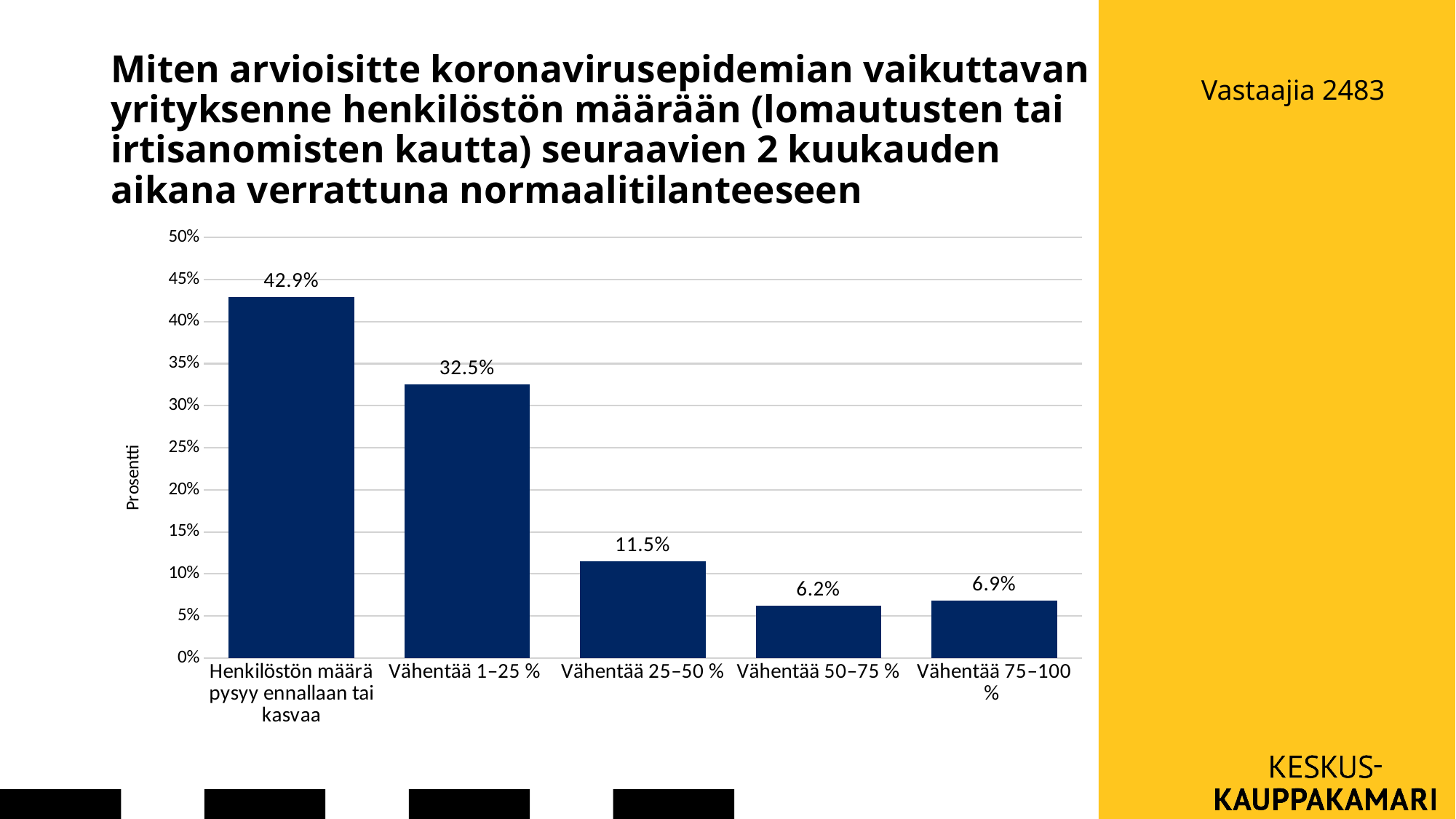
Which category has the highest value? Henkilöstön määrä pysyy ennallaan tai kasvaa What is the difference between the values for "Henkilöstön määrä pysyy ennallaan tai kasvaa" and "Vähentää 1–25 %"? 10.4% What is the value for "Vähentää 50–75 %"? 6.2% What is the value for "Vähentää 75–100 %"? 6.9% Which is larger, the value for "Vähentää 50–75 %" or "Vähentää 75–100 %"? Vähentää 75–100 % What is the label of the vertical axis? Prosentti Which category has the lowest value? Vähentää 50–75 % How many categories are shown on the x axis? 5 What is the value for "Vähentää 1–25 %"? 32.5% What is the value for "Henkilöstön määrä pysyy ennallaan tai kasvaa"? 42.9% What is the value for "Vähentää 25–50 %"? 11.5% What kind of chart is shown on the slide? Bar chart